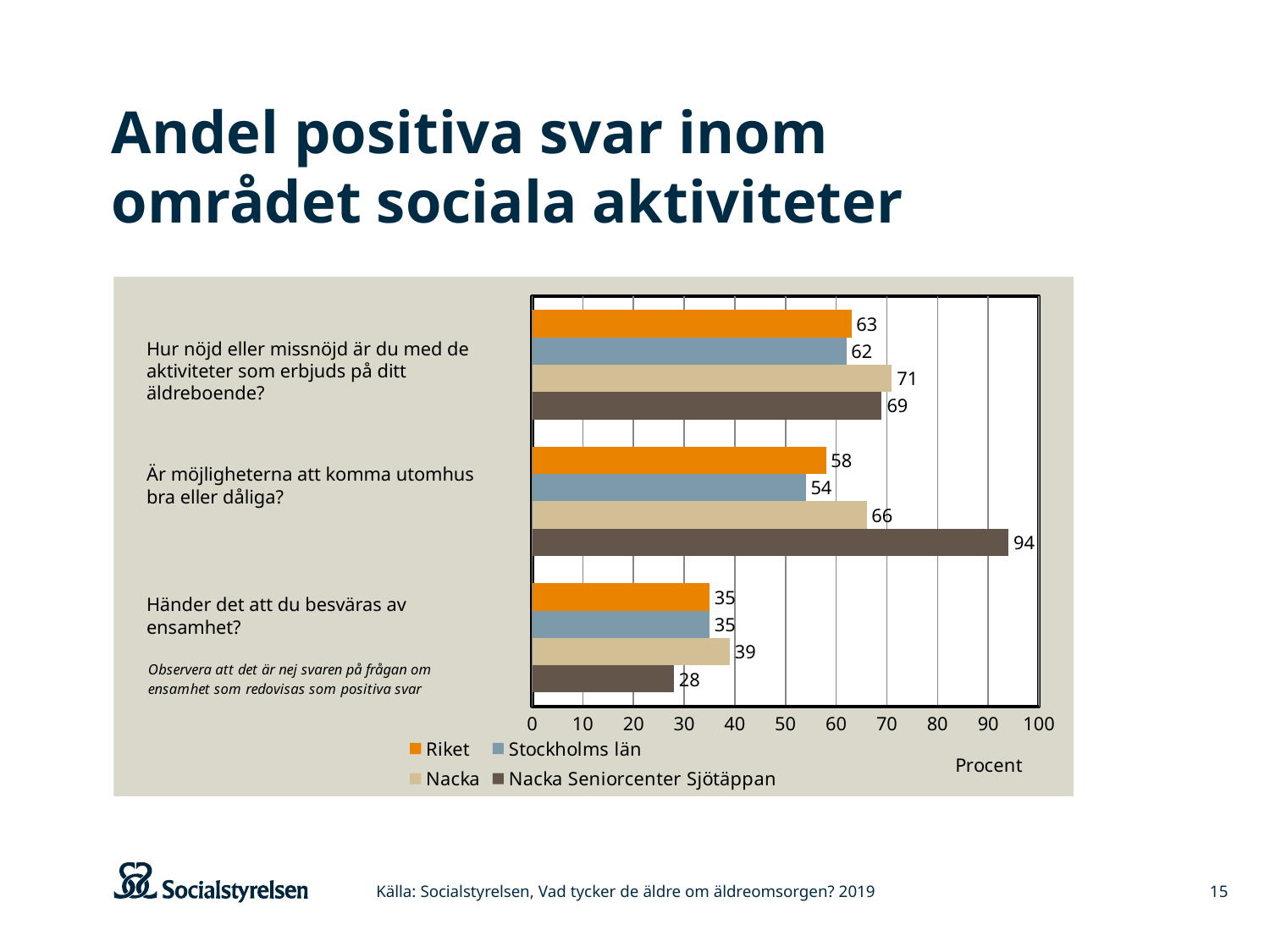
How many series does the legend list? 4 Which is larger on the question "Hur nöjd eller missnöjd är du med de aktiviteter som erbjuds på ditt äldreboende?": Nacka or Nacka Seniorcenter Sjötäppan? Nacka What is the difference between Nacka Seniorcenter Sjötäppan and Nacka on the question "Är möjligheterna att komma utomhus bra eller dåliga?"? 28 What is the value for Riket on the question "Hur nöjd eller missnöjd är du med de aktiviteter som erbjuds på ditt äldreboende?"? 63 What kind of chart is shown on the slide? Bar chart How many questions (categories) are shown on the chart? 3 Which series has the lowest value on the question "Händer det att du besväras av ensamhet?"? Nacka Seniorcenter Sjötäppan What is the value for Nacka Seniorcenter Sjötäppan on the question "Är möjligheterna att komma utomhus bra eller dåliga?"? 94 Which series has the highest value on the question "Är möjligheterna att komma utomhus bra eller dåliga?"? Nacka Seniorcenter Sjötäppan What is the value for Stockholms län on the question "Händer det att du besväras av ensamhet?"? 35 What is the value for Nacka on the question "Är möjligheterna att komma utomhus bra eller dåliga?"? 66 What is the label of the horizontal axis? Procent